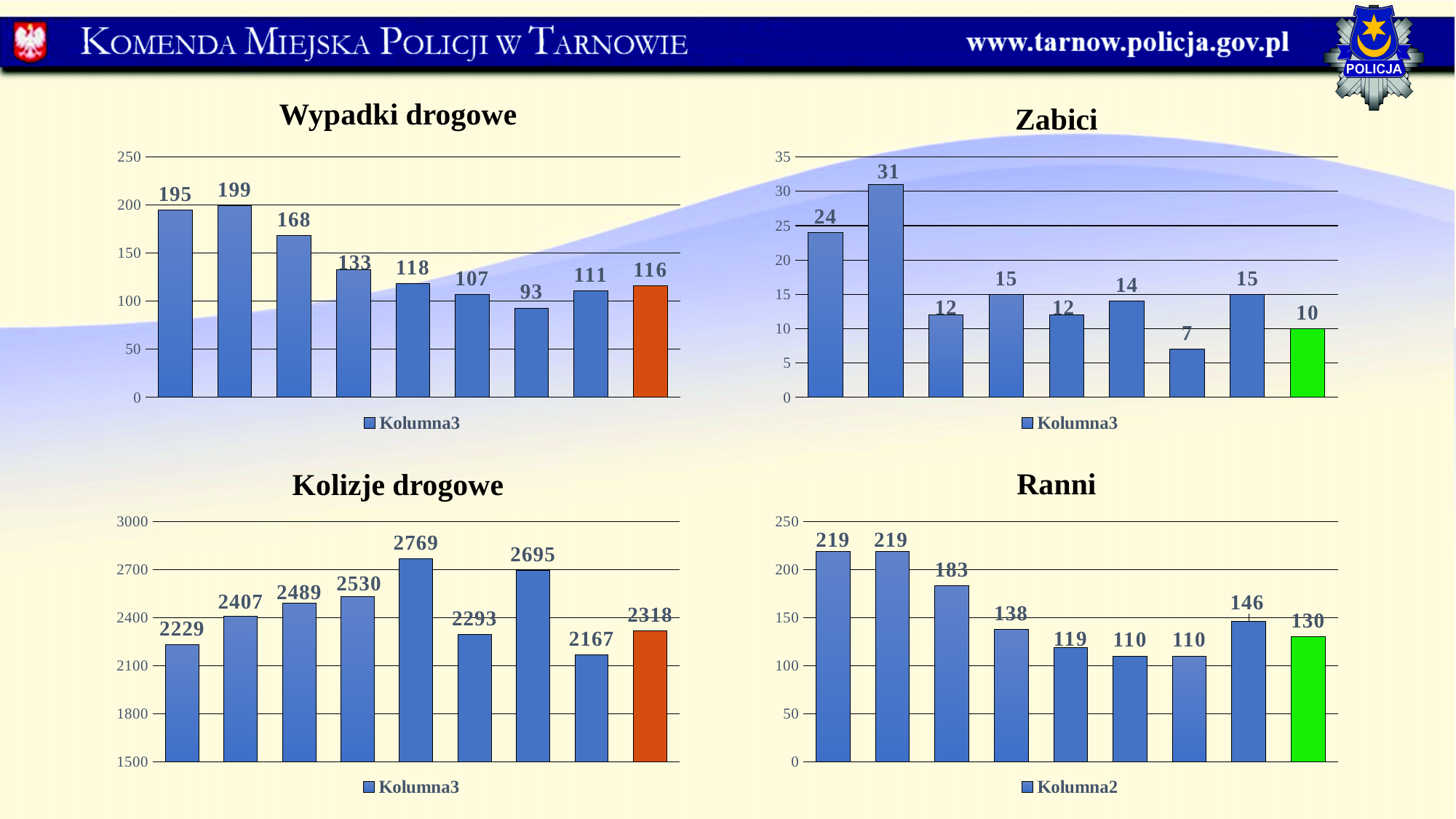
In the 'Zabici' chart, what is the highest value shown? 31 In the 'Wypadki drogowe' chart, what is the lowest value shown? 93 In the 'Kolizje drogowe' chart, what is the value of the last (orange) bar? 2318 In the 'Wypadki drogowe' chart, what is the highest value shown? 199 In the 'Ranni' chart, what is the value of the last (green) bar? 130 In the 'Kolizje drogowe' chart, what is the highest value shown? 2769 In the 'Ranni' chart, is the first bar larger or smaller than the third bar? larger In the 'Zabici' chart, what is the difference between the highest and lowest values? 24 What legend entry is shown under the 'Ranni' chart? Kolumna2 In the 'Wypadki drogowe' chart, what is the value of the last (orange) bar? 116 In the 'Zabici' chart, what is the lowest value shown? 7 In the 'Kolizje drogowe' chart, how many bars are plotted? 9